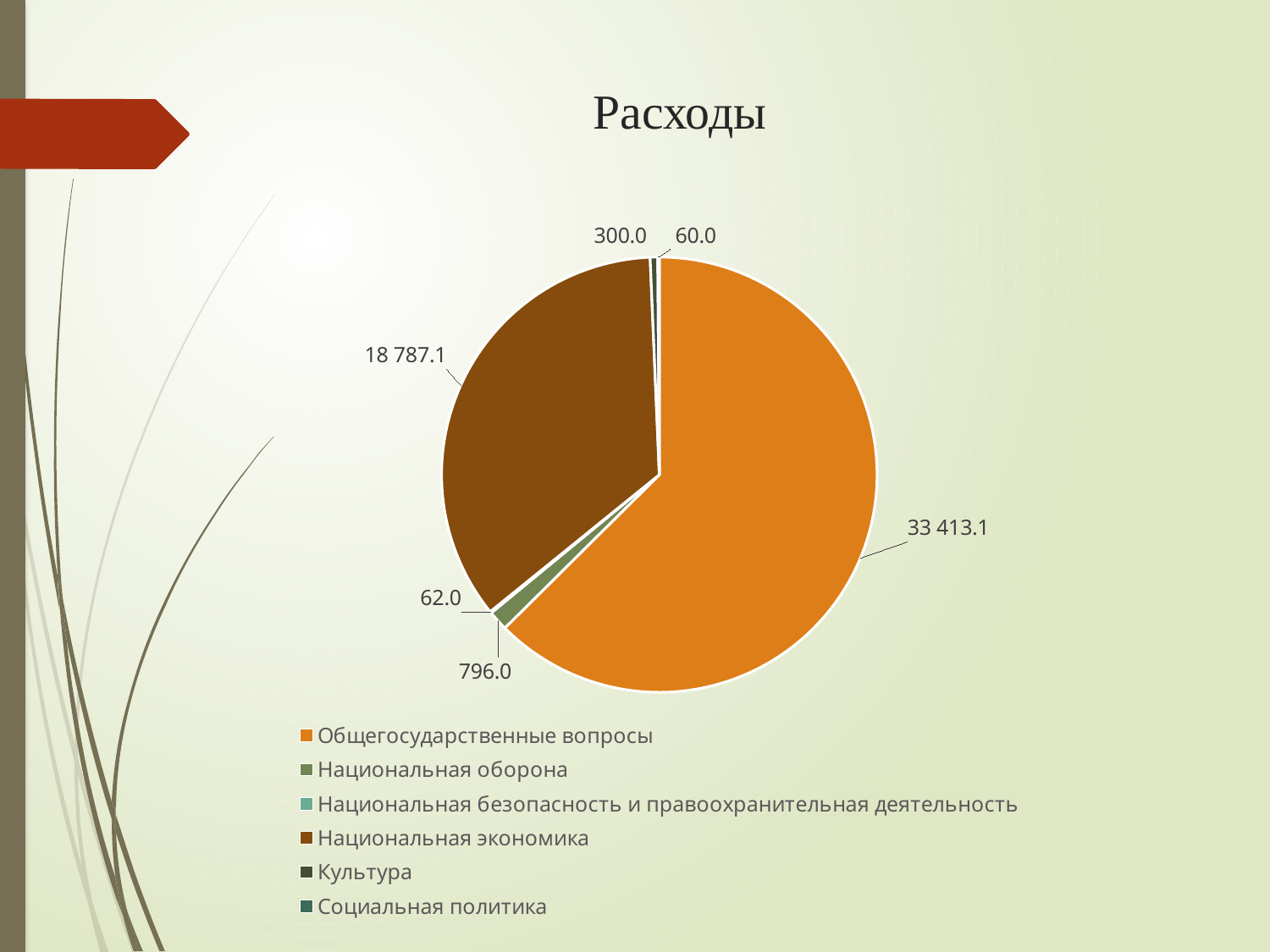
What is the difference between the values for Общегосударственные вопросы and Национальная экономика? 14 626.0 What is the value for Национальная экономика? 18 787.1 What is the value for Общегосударственные вопросы? 33 413.1 Which category has the largest slice? Общегосударственные вопросы What is the title of the chart? Расходы How many categories does the legend list? 6 What type of chart is shown on the slide? pie chart What is the value for Национальная оборона? 796.0 What is the value for Социальная политика? 60.0 Which category has the smallest value? Социальная политика Which is larger, the value for Национальная оборона or the value for Культура? Национальная оборона What is the value for Культура? 300.0